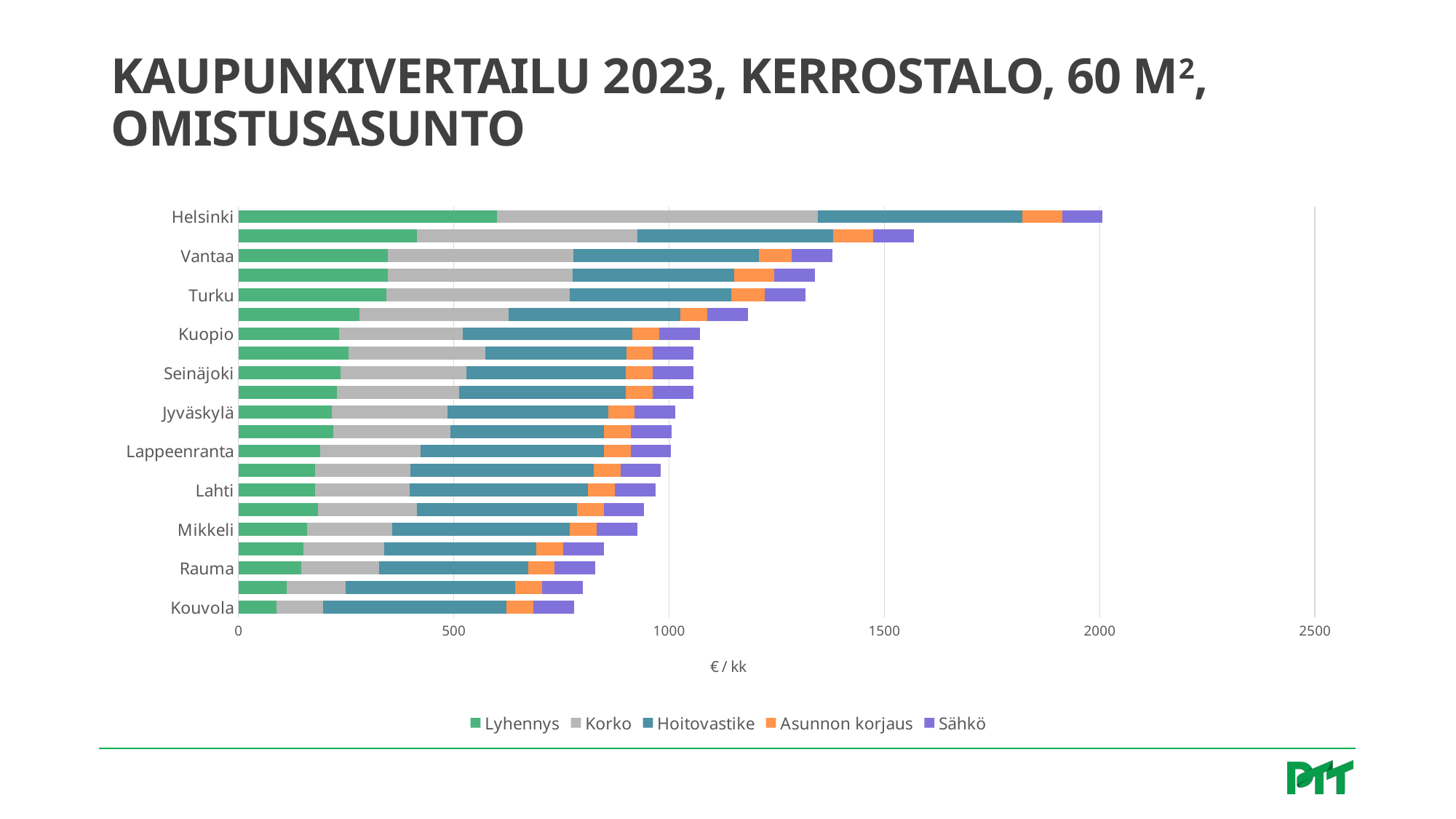
Is the total bar for Kouvola greater or less than 1000? less How many series does the legend list? 5 Is the total bar for Turku greater or less than 1000? greater What unit is shown on the horizontal axis title? € / kk Is the total bar for Vantaa greater or less than 1500? less What kind of chart is shown on the slide? Stacked horizontal bar chart Do the total bar lengths increase or decrease going from the top of the chart to the bottom? decrease Which city has the longest total bar? Helsinki Which series are listed in the legend? Lyhennys, Korko, Hoitovastike, Asunnon korjaus, Sähkö Which city has the larger total bar, Turku or Kouvola? Turku